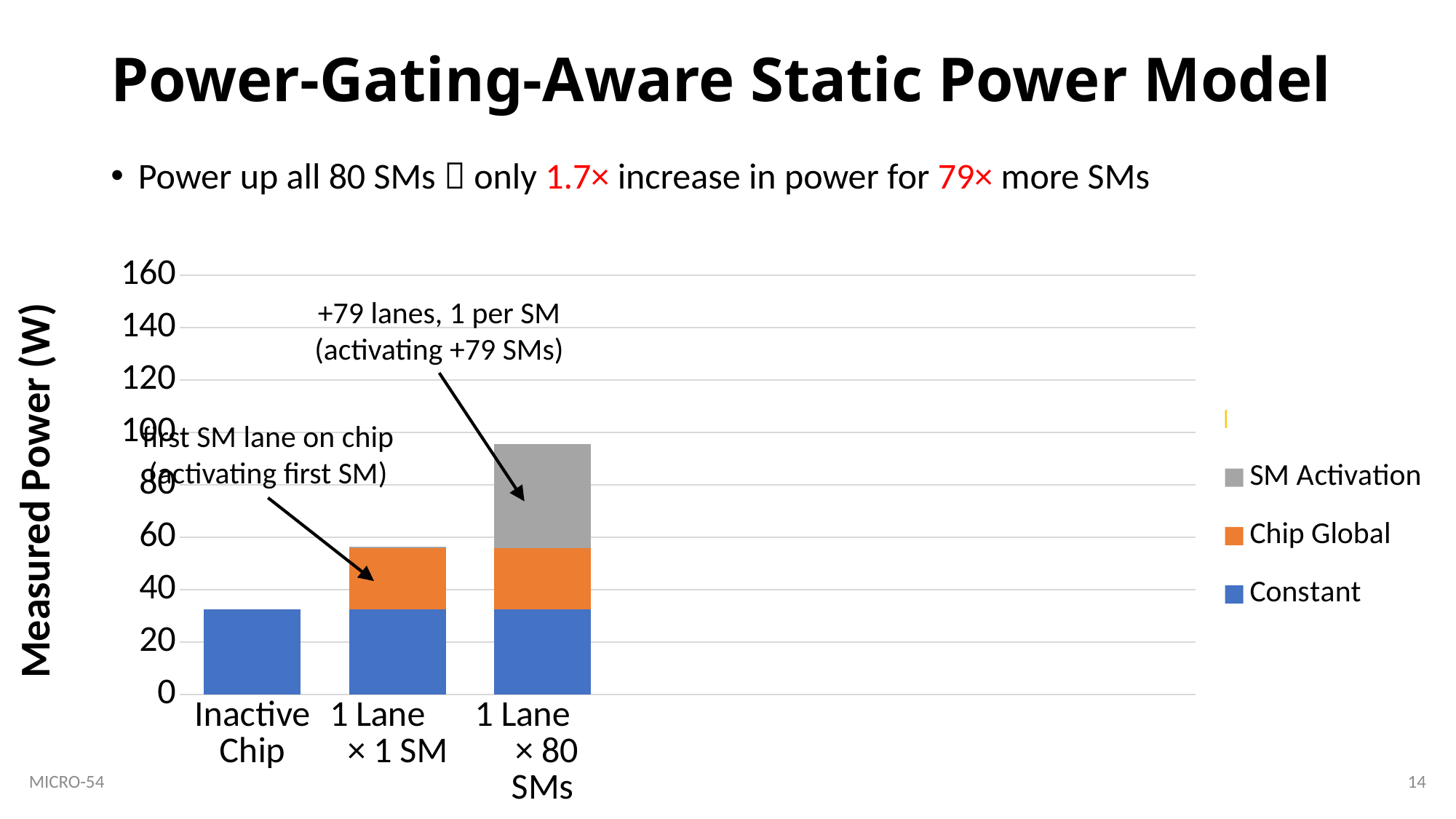
How many categories are shown on the x axis of the chart? 3 Which category has the highest total measured power? 1 Lane × 80 SMs Is the total measured power for 1 Lane × 80 SMs greater or less than 80? greater What kind of chart is shown on the slide? stacked bar chart Which series is shown in gray in the chart's legend? SM Activation Which has a larger total measured power, Inactive Chip or 1 Lane × 1 SM? 1 Lane × 1 SM Which category has the lowest total measured power? Inactive Chip Do the total bar heights rise or fall from left to right along the x axis? rise What is the title of the chart's vertical axis? Measured Power (W) Is the total measured power for Inactive Chip greater or less than 40? less Is the total measured power for 1 Lane × 1 SM greater or less than 40? greater